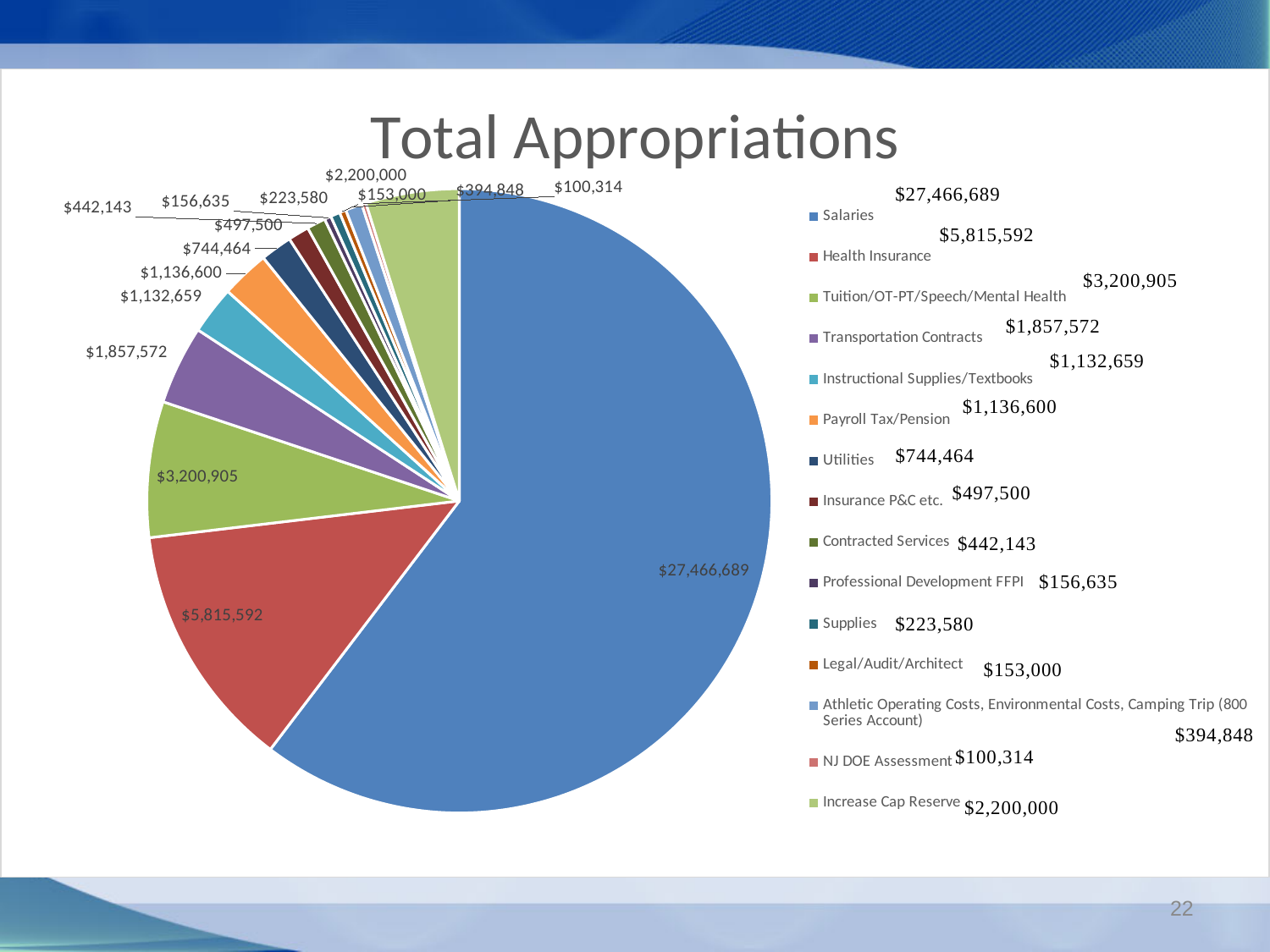
What is the value for Health Insurance? $5,815,592 How many categories does the pie chart show? 15 What is the title of the chart? Total Appropriations What is the difference between Health Insurance and Tuition/OT-PT/Speech/Mental Health? $2,614,687 Which category has the smallest value? NJ DOE Assessment What is the value for Salaries? $27,466,689 What type of chart is shown on the slide? pie chart What is the value for Increase Cap Reserve? $2,200,000 What is the value for Transportation Contracts? $1,857,572 Which is larger, Utilities or Insurance P&C etc.? Utilities What is the difference between Salaries and Health Insurance? $21,651,097 Which category has the largest value? Salaries